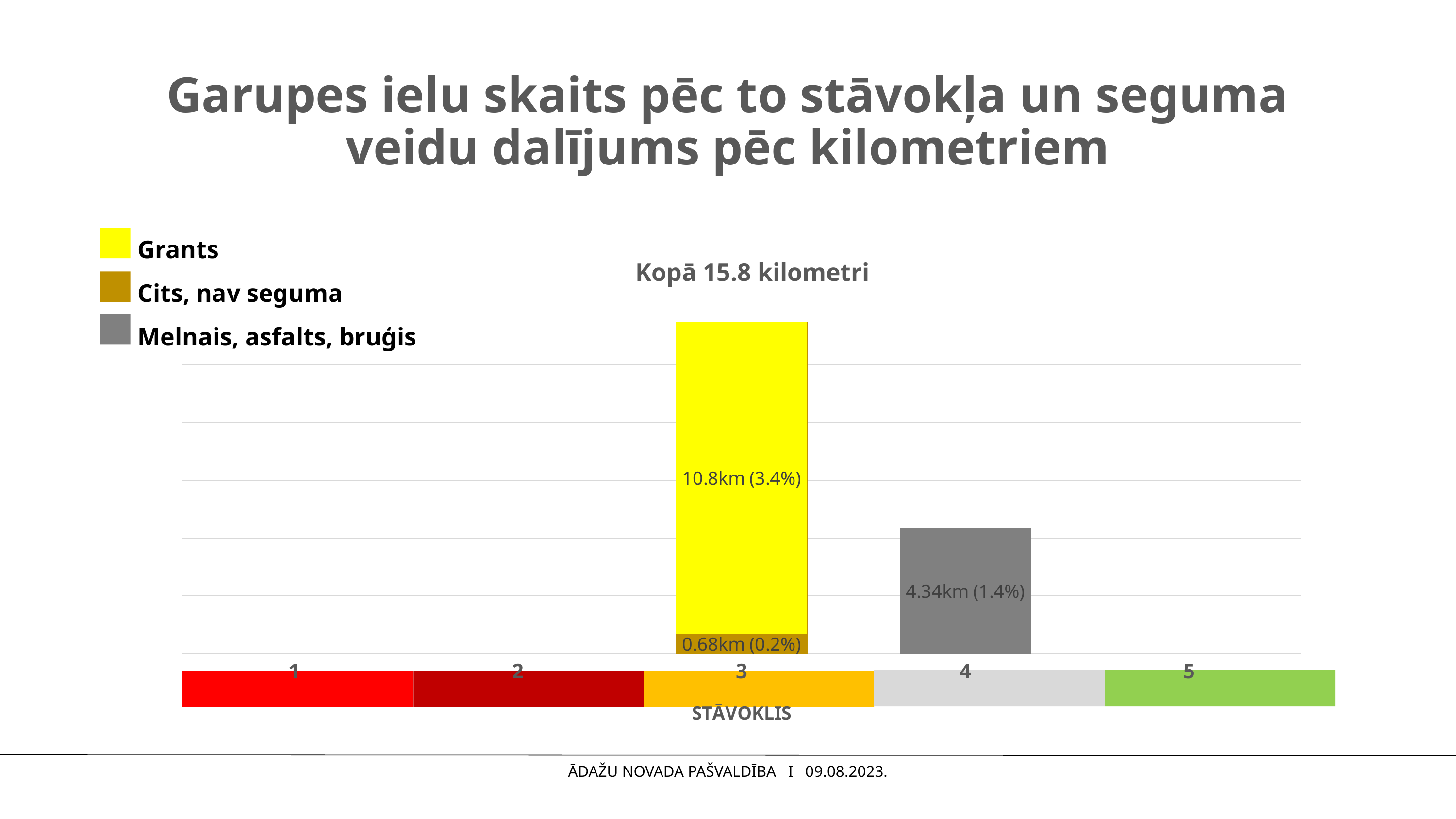
Which category has the tallest stacked bar? 3 How many categories are shown on the x axis? 5 What is the value of the Melnais, asfalts, bruģis series for category 4? 4.34km (1.4%) What is the difference in kilometres between the Grants value for category 3 and the Melnais, asfalts, bruģis value for category 4? 6.46km What kind of chart is shown on the slide? Stacked bar chart What is the value of the Cits, nav seguma series for category 3? 0.68km (0.2%) What is the total length of the stacked bar for category 3? 11.48km Which colour represents the Grants series in the legend? Yellow What is the value of the Grants series for category 3? 10.8km (3.4%) What total is stated above the chart? Kopā 15.8 kilometri How many series does the legend list? 3 Which is larger: the Grants value for category 3 or the Melnais, asfalts, bruģis value for category 4? Grants value for category 3